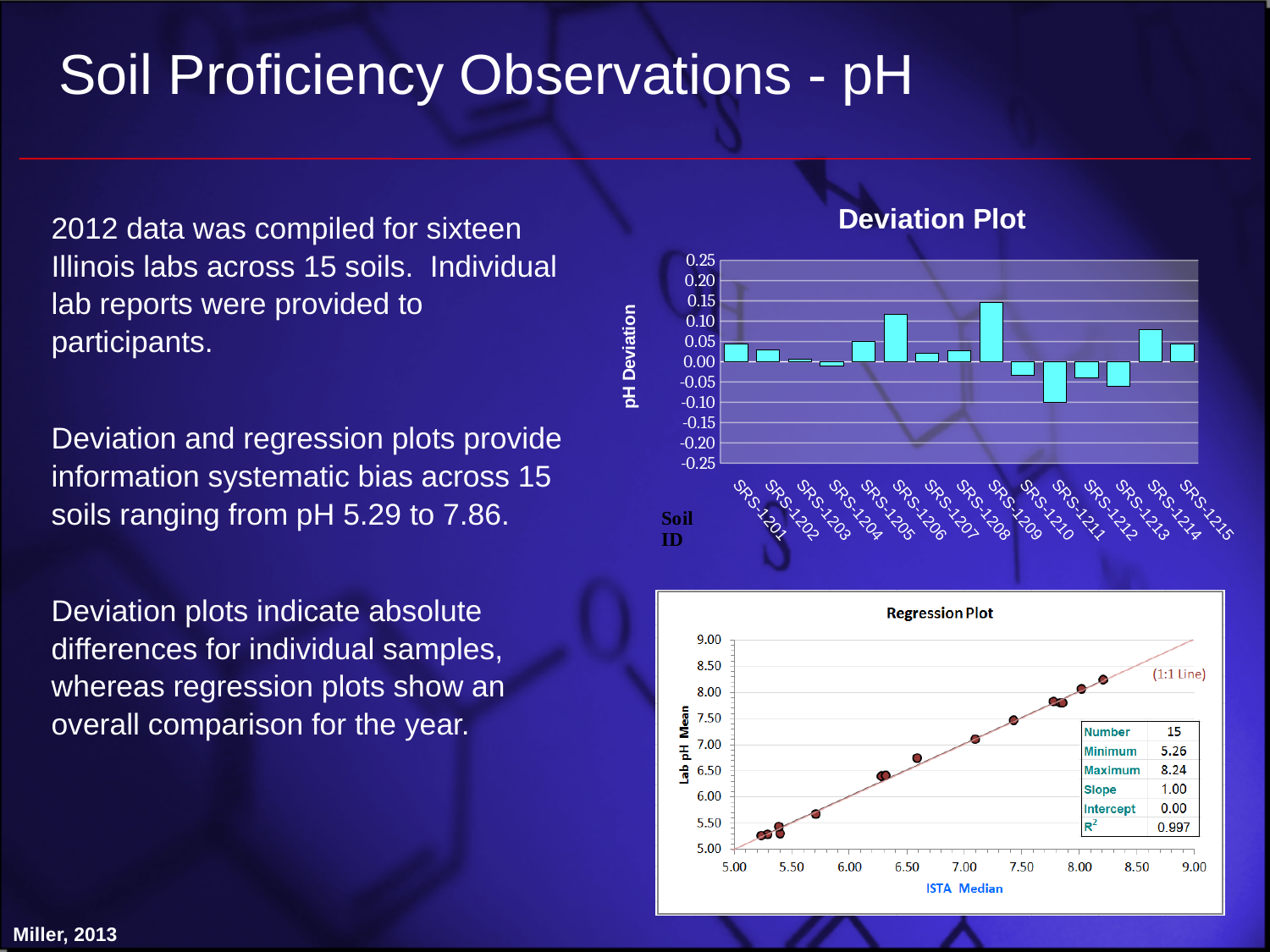
In the Regression Plot, what is the Maximum value shown in the table? 8.24 In the Deviation Plot, is the value for SRS-1211 greater or less than -0.05? less In the Deviation Plot, which soil ID has the highest pH deviation? SRS-1209 In the Regression Plot, what is the Slope shown in the table? 1.00 In the Deviation Plot, which soil ID has the lowest pH deviation? SRS-1211 In the Deviation Plot, is the value for SRS-1214 greater or less than 0.05? greater In the Deviation Plot, is the value for SRS-1209 greater or less than 0.10? greater What type of chart is the Deviation Plot? bar chart What is the y-axis label of the Deviation Plot? pH Deviation In the Deviation Plot, which has the larger pH deviation, SRS-1206 or SRS-1207? SRS-1206 In the Regression Plot, what is the R² value shown in the table? 0.997 How many soil IDs are shown on the x axis of the Deviation Plot? 15